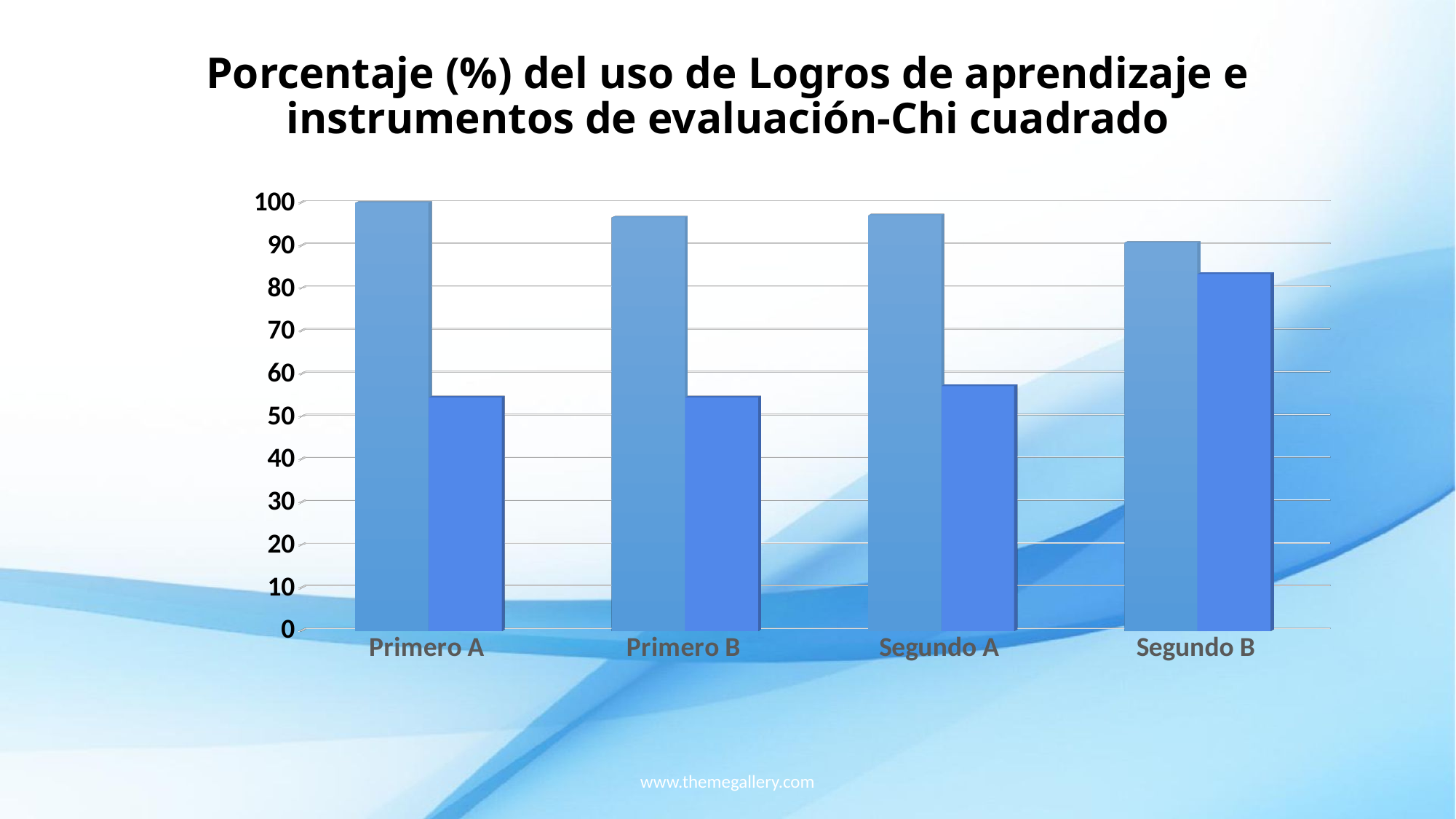
How many categories are shown on the x axis of the chart? 4 Is the value of the lighter blue bar for Primero B greater or less than 90? greater Among the lighter blue bars, which category has the lowest value? Segundo B Is the value of the darker blue bar for Segundo B greater or less than 80? greater What kind of chart is shown on the slide? bar chart How many bars are plotted for each category in the chart? 2 For Primero A, which bar is larger, the lighter blue bar or the darker blue bar? the lighter blue bar Among the darker blue bars, which category has the highest value? Segundo B What is the title of the chart on the slide? Porcentaje (%) del uso de Logros de aprendizaje e instrumentos de evaluación-Chi cuadrado Is the value of the darker blue bar for Primero A greater or less than 60? less Among the lighter blue bars, which category has the highest value? Primero A